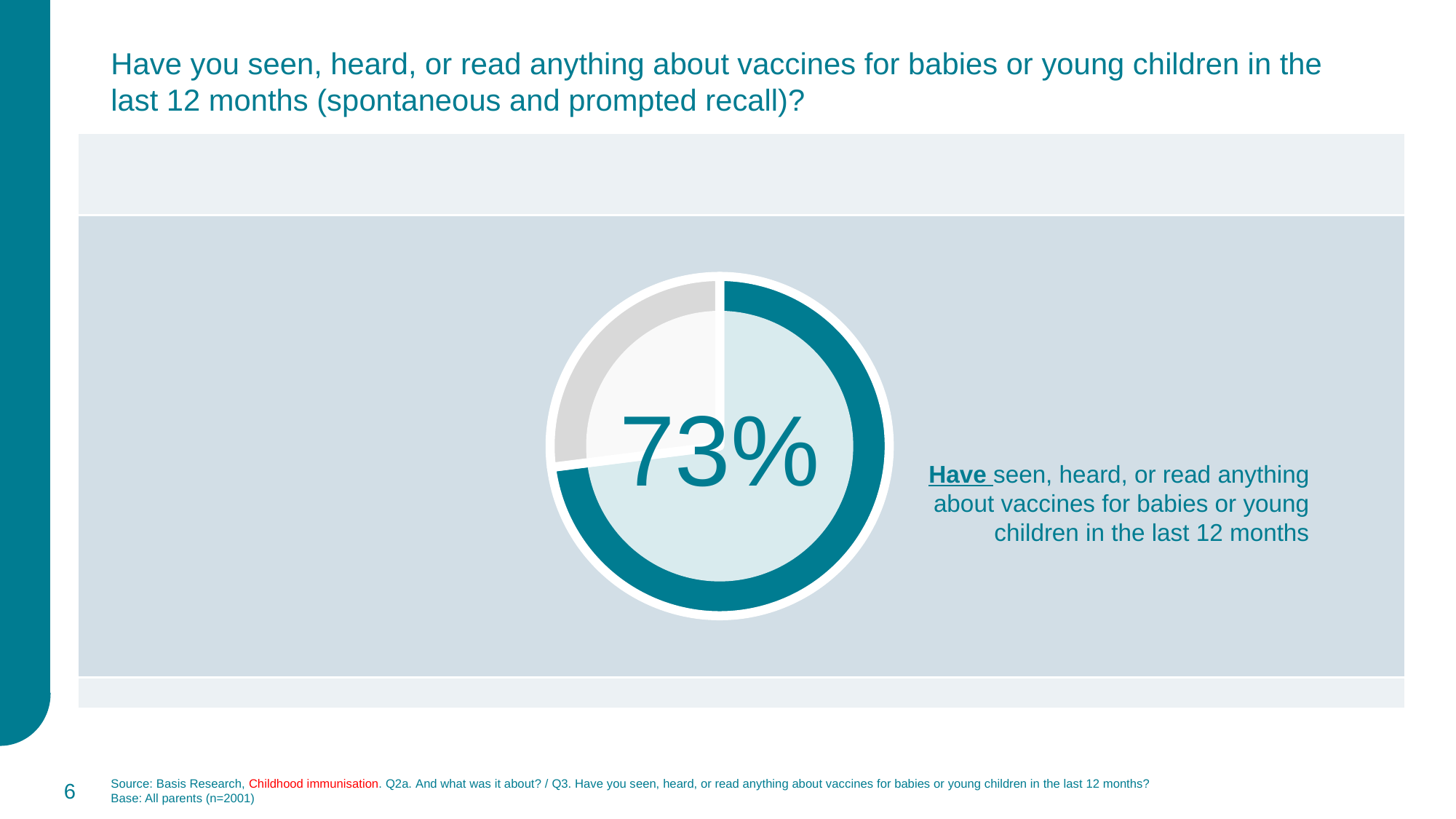
What is the base (sample size) stated for the chart? All parents (n=2001) Which slice is larger: the teal 'Have seen' slice or the grey slice? the teal 'Have seen' slice Is the share of parents who have not seen, heard, or read anything about vaccines greater or less than 50%? less Is the share of parents who have seen, heard, or read anything about vaccines greater or less than 50%? greater What share of the pie is taken by the slice that is not the 73% 'Have seen' slice? 27% What percentage of parents have seen, heard, or read anything about vaccines for babies or young children in the last 12 months? 73% What value is printed in the centre of the chart? 73% What colour is the slice representing parents who have seen, heard, or read anything about vaccines? teal What kind of chart is shown on the slide? pie chart How many slices does the pie chart have? 2